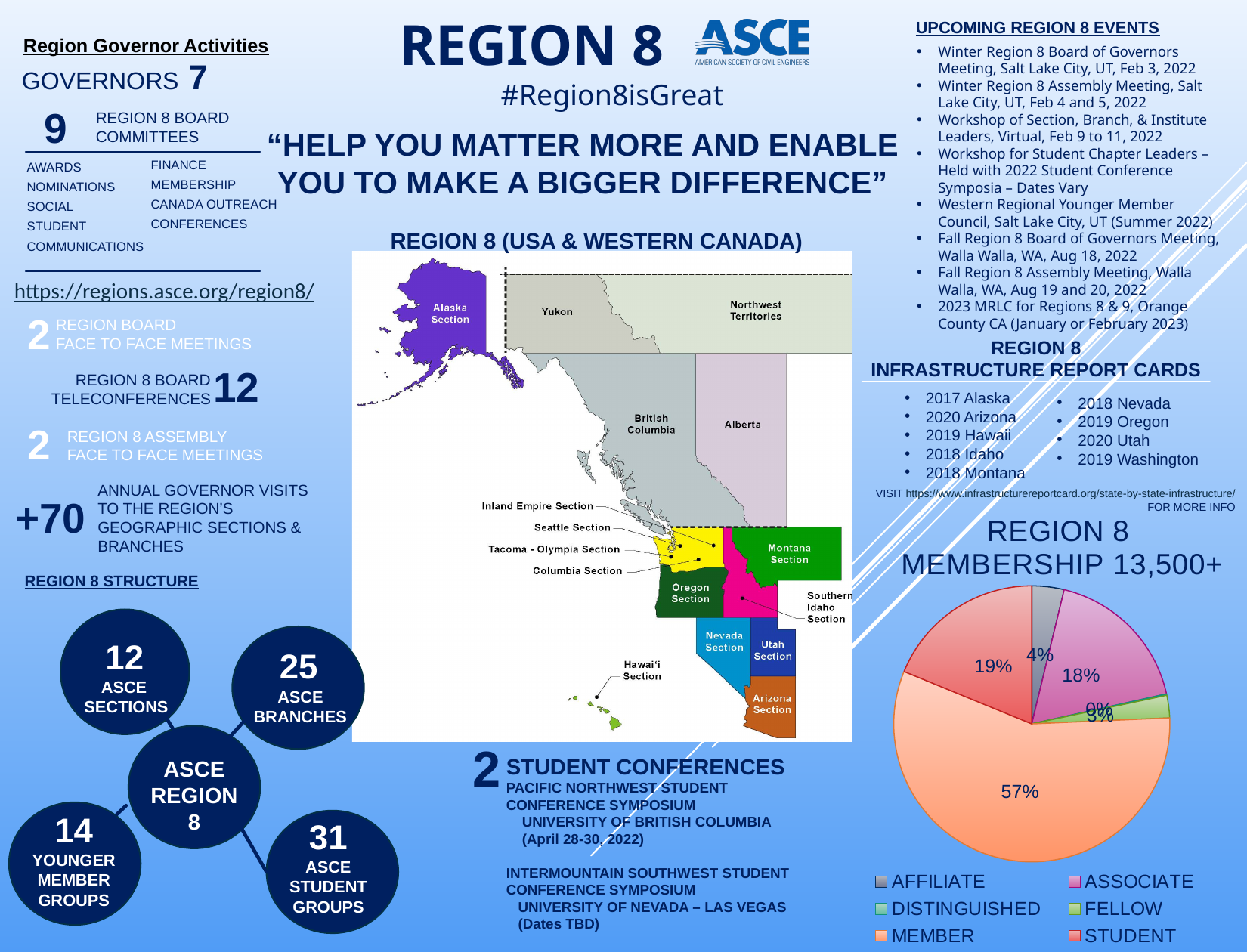
Which membership category has the largest share of the pie chart? MEMBER What is the difference in percentage points between the MEMBER and STUDENT shares? 38% How many membership categories does the pie chart legend list? 6 What percentage of Region 8 membership is AFFILIATE? 4% What percentage of Region 8 membership is FELLOW? 3% What share of Region 8 membership is MEMBER? 57% Which membership category has the smallest share of the pie chart? DISTINGUISHED Which is larger in the membership pie chart, MEMBER or STUDENT? MEMBER What percentage of Region 8 membership is STUDENT? 19% What percentage of Region 8 membership is ASSOCIATE? 18% What type of chart is used to show Region 8 membership? pie chart What is the title of the pie chart? REGION 8 MEMBERSHIP 13,500+